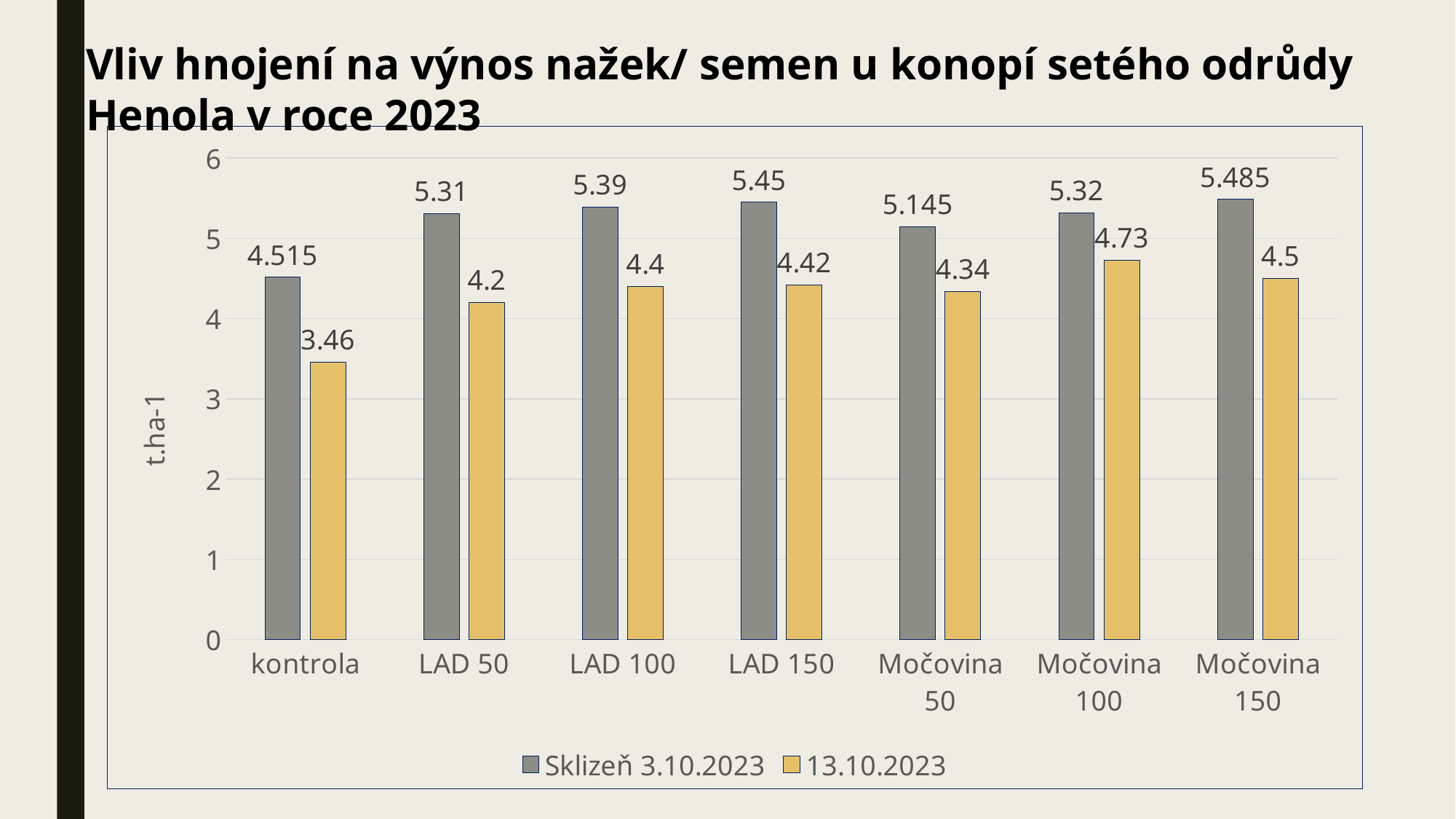
Which category has the lowest value in the 13.10.2023 series? kontrola Which category has the highest value in the Sklizeň 3.10.2023 series? Močovina 150 How many categories are shown on the x axis? 7 What is the value for LAD 100 in the Sklizeň 3.10.2023 series? 5.39 What is the value for Močovina 100 in the 13.10.2023 series? 4.73 What is the difference between the Sklizeň 3.10.2023 and 13.10.2023 values for Močovina 100? 0.59 How many series does the legend list? 2 What is the difference between the Sklizeň 3.10.2023 and 13.10.2023 values for kontrola? 1.055 Which is larger: the 13.10.2023 value for LAD 150 or for Močovina 150? Močovina 150 What type of chart is shown on the slide? bar chart What is the value for kontrola in the 13.10.2023 series? 3.46 Which category has the highest value in the 13.10.2023 series? Močovina 100